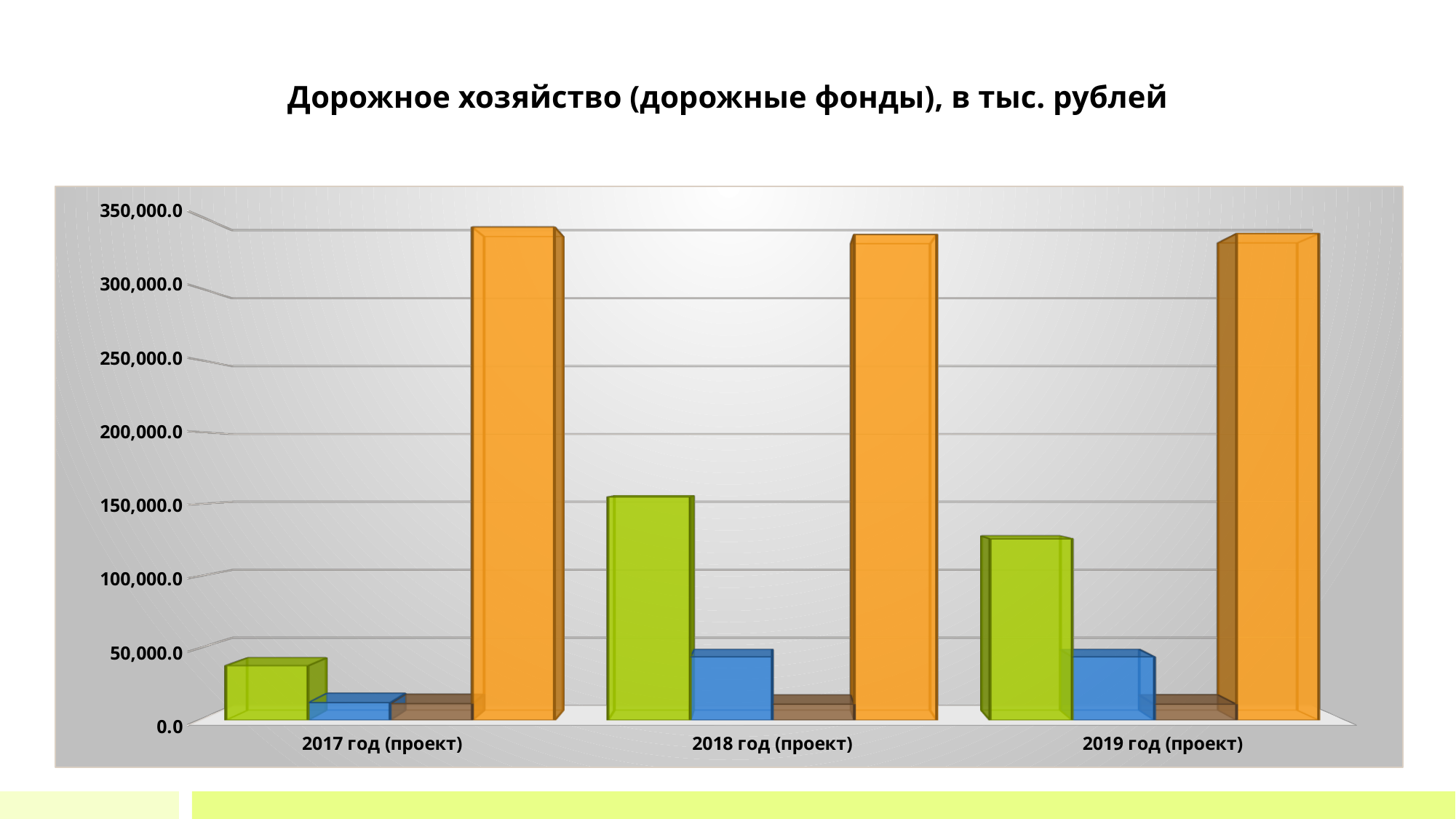
Is the value of the green bar for 2017 год (проект) greater or less than 50,000.0? less Which is larger: the green bar for 2018 год (проект) or the green bar for 2019 год (проект)? 2018 год (проект) Which coloured bar is the tallest in 2019 год (проект)? orange How many bars are shown for each year category? 4 How many categories (years) are shown on the x axis? 3 In which year is the green bar the shortest? 2017 год (проект) Which is larger in 2017 год (проект): the green bar or the blue bar? green bar In which year is the green bar the tallest? 2018 год (проект) Is the value of the green bar for 2019 год (проект) greater or less than 150,000.0? less Is the value of the orange bar for 2017 год (проект) greater or less than 300,000.0? greater What type of chart is shown on the slide? bar chart What is the title of the chart? Дорожное хозяйство (дорожные фонды), в тыс. рублей